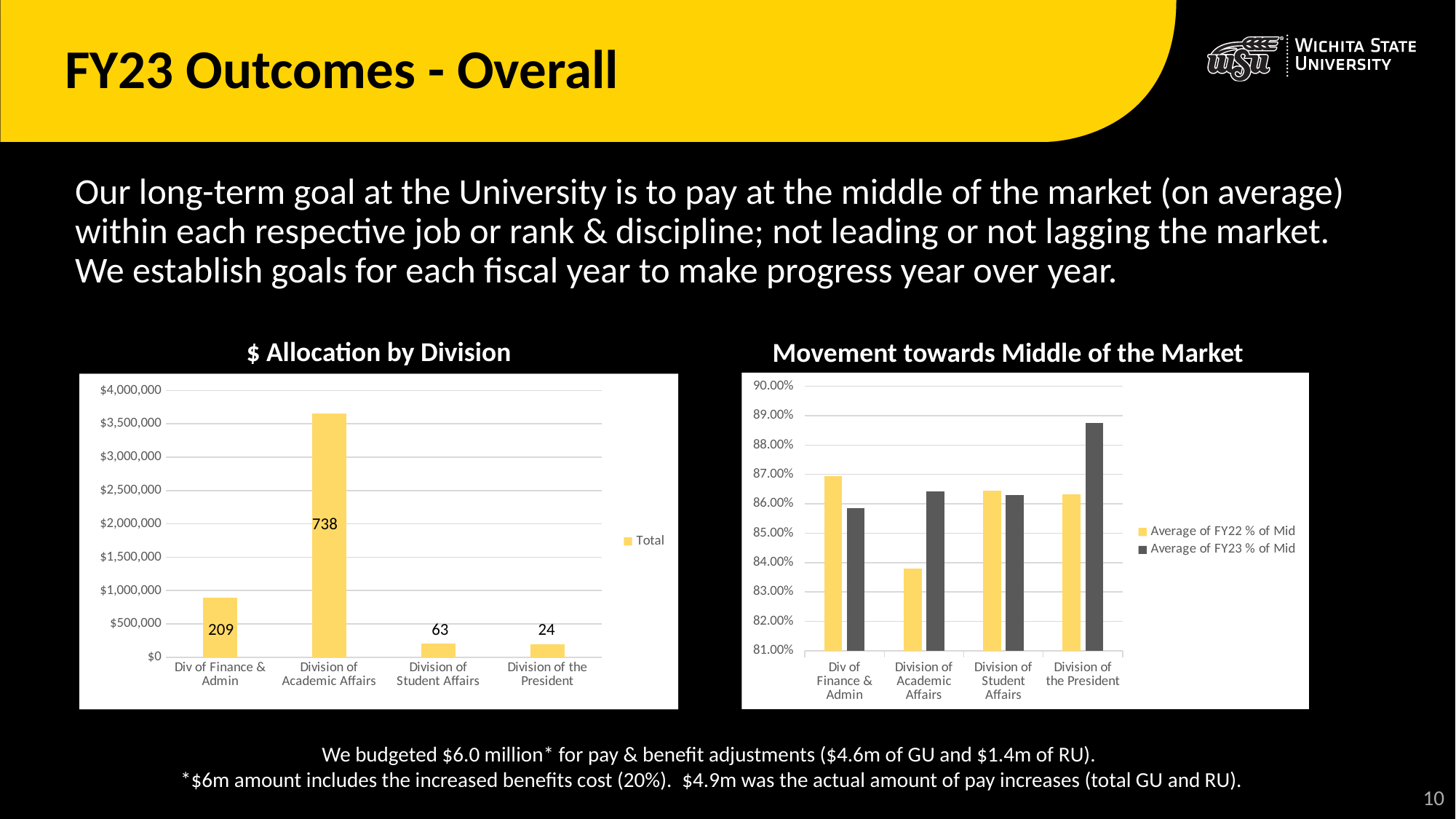
On the "Movement towards Middle of the Market" chart, how many series does the legend list? 2 On the "$ Allocation by Division" chart, is the value for Div of Finance & Admin greater or less than $1,000,000? less On the "$ Allocation by Division" chart, what data label is printed on the bar for Division of Academic Affairs? 738 On the "Movement towards Middle of the Market" chart, for Div of Finance & Admin, which is larger: Average of FY22 % of Mid or Average of FY23 % of Mid? Average of FY22 % of Mid On the "$ Allocation by Division" chart, how many divisions are shown on the x axis? 4 What kind of chart is "Movement towards Middle of the Market"? Bar chart On the "$ Allocation by Division" chart, what data label is printed on the bar for Division of the President? 24 On the "$ Allocation by Division" chart, which division has the highest bar? Division of Academic Affairs On the "Movement towards Middle of the Market" chart, which division has the highest Average of FY23 % of Mid? Division of the President On the "Movement towards Middle of the Market" chart, which division has the lowest Average of FY22 % of Mid? Division of Academic Affairs On the "Movement towards Middle of the Market" chart, is the Average of FY23 % of Mid for Division of the President greater or less than 88.00%? greater On the "$ Allocation by Division" chart, is the value for Division of Academic Affairs greater or less than $3,500,000? greater